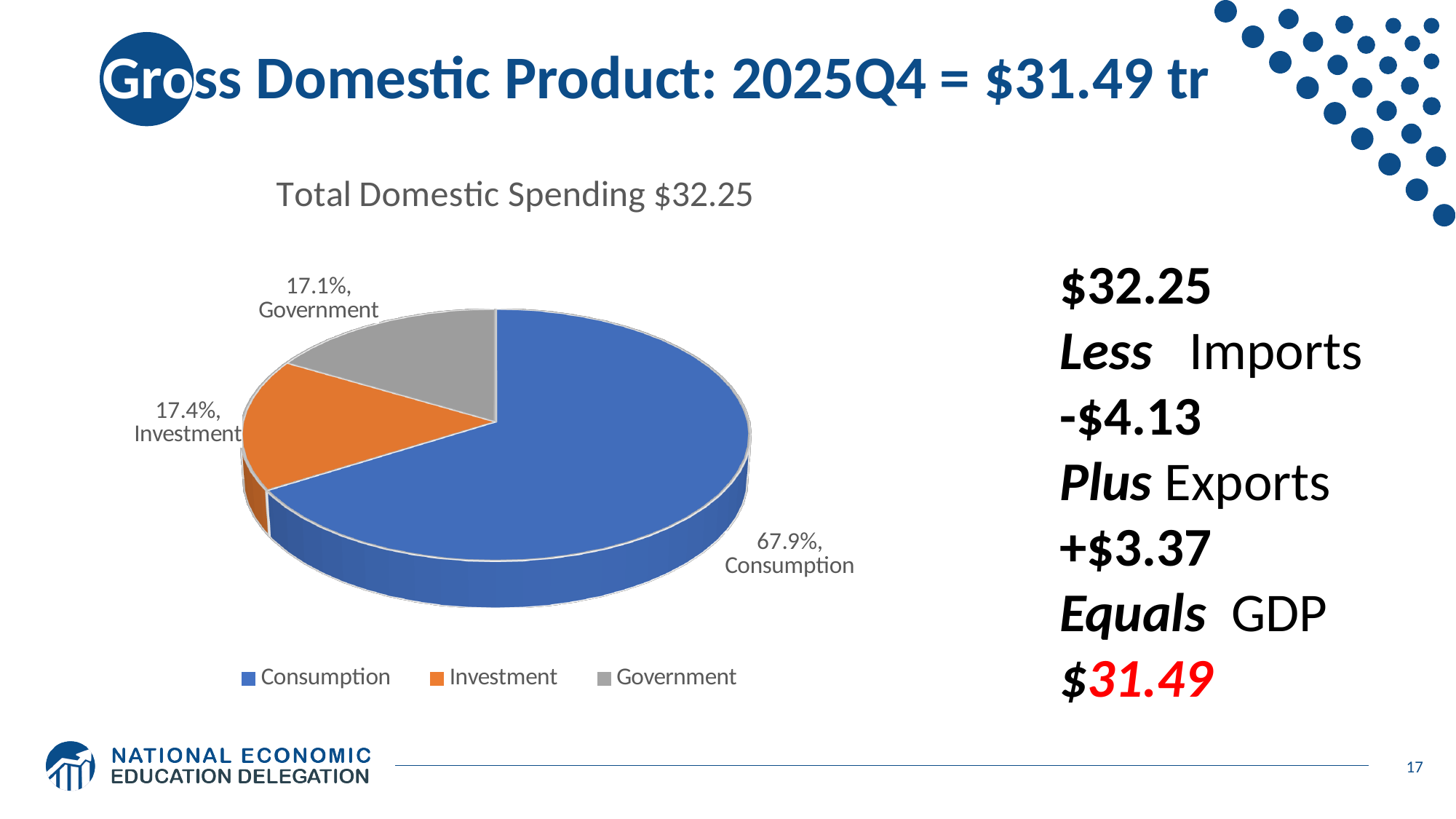
Which is larger, the Consumption slice or the Government slice? Consumption By how many percentage points does Consumption's share exceed Investment's share? 50.5 percentage points What percentage of total domestic spending is Consumption? 67.9% What kind of chart is shown on the slide? Pie chart What percentage of total domestic spending is Investment? 17.4% What is the title of the pie chart? Total Domestic Spending $32.25 Which category has the largest slice of the pie? Consumption Which category has the smallest slice of the pie? Government How many entries does the legend list? 3 How many slices does the pie chart have? 3 What colour is the Investment slice in the pie chart? Orange What percentage of total domestic spending is Government? 17.1%